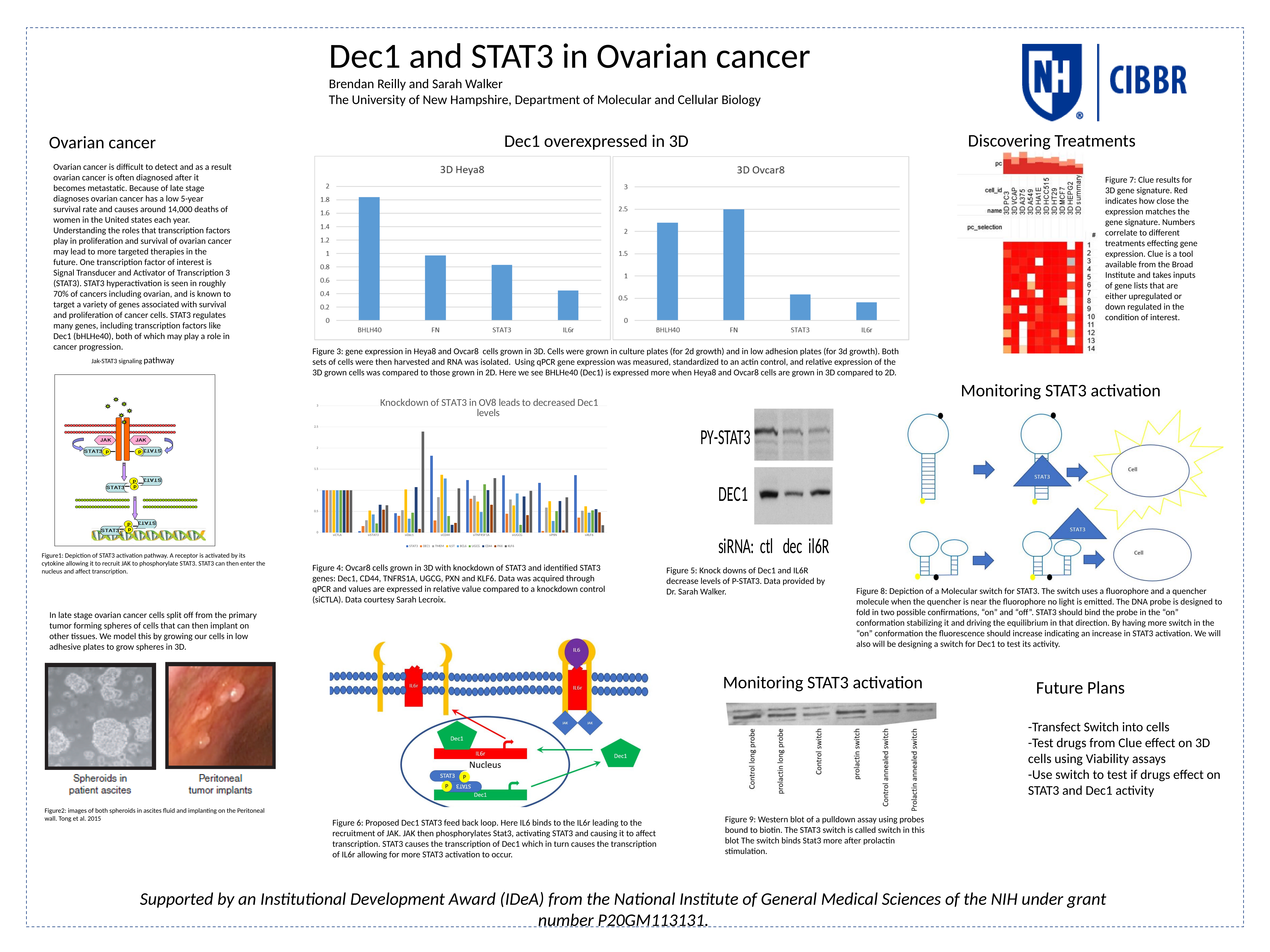
In the 3D Heya8 chart, which gene has the lowest relative expression? IL6r How many genes are shown on the x axis of the 3D Ovcar8 chart? 4 In the 3D Ovcar8 chart, which gene has the lowest relative expression? IL6r In the 3D Heya8 chart, do the bar values rise or fall from left to right along the x axis? fall What kind of chart is the 3D Heya8 chart? bar chart In the 3D Heya8 chart, is the value for IL6r greater or less than 0.6? less In the 3D Heya8 chart, which gene has the highest relative expression? BHLH40 In the 3D Ovcar8 chart, which gene has the highest relative expression? FN In the 3D Ovcar8 chart, is the value for IL6r greater or less than 0.5? less In the 3D Ovcar8 chart, is the value for BHLH40 greater or less than 2? greater In the 3D Ovcar8 chart, which is larger, the value for STAT3 or the value for FN? FN